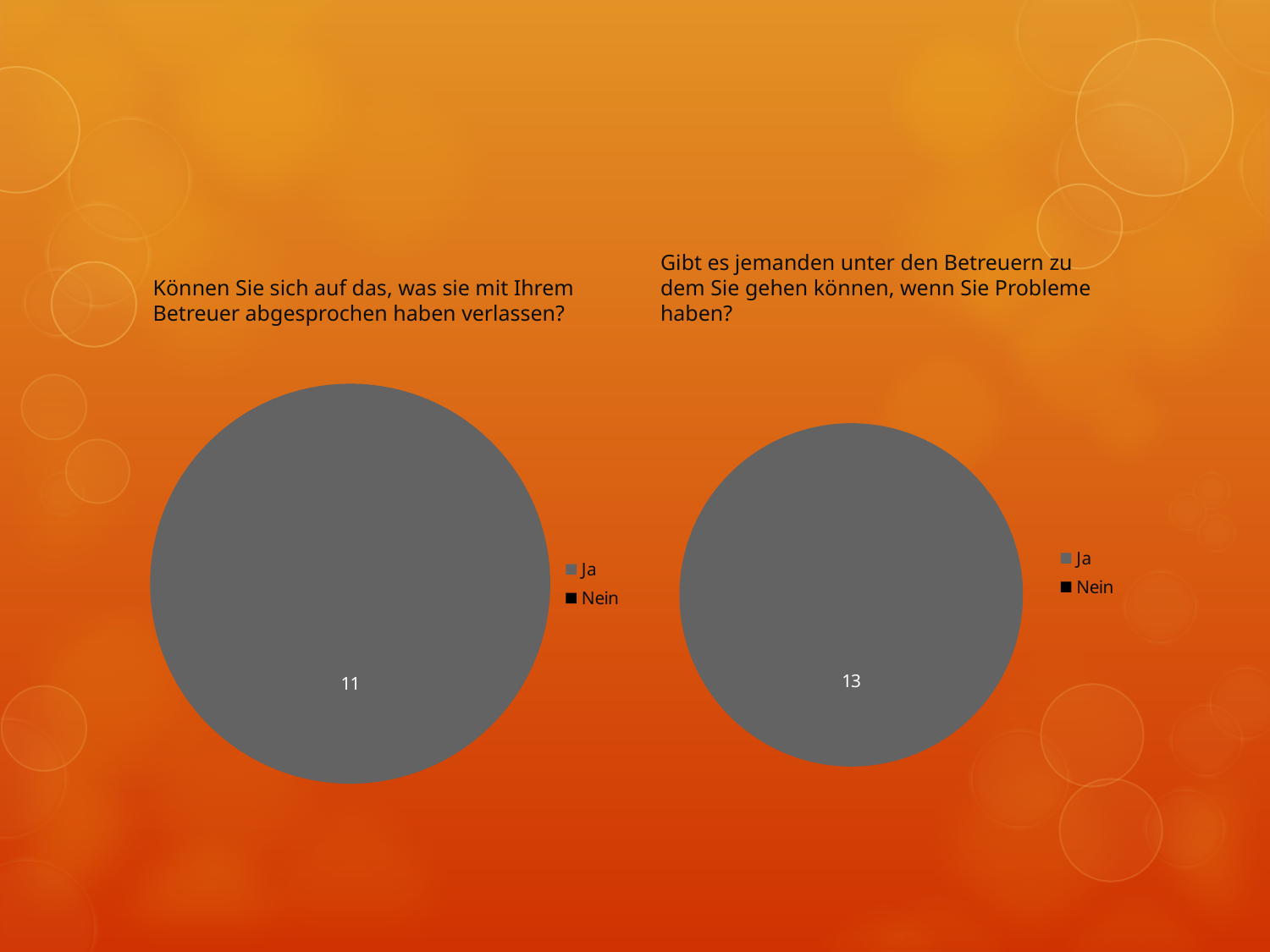
What is the difference between the value printed on the right chart (13) and the value printed on the left chart (11)? 2 Which chart shows the larger printed value, the left chart or the right chart? the right chart In the left chart ("Können Sie sich auf das, was sie mit Ihrem Betreuer abgesprochen haben verlassen?"), what value is printed on the pie? 11 What are the two legend entries shown for the right chart? Ja and Nein How many entries does the legend of the left chart list? 2 What type of chart is shown on the left of the slide? pie chart Is the value printed on the right chart greater or less than 10? greater In the right chart, what share of the pie does the "Ja" slice take up? 100% How many entries does the legend of the right chart list? 2 In the right chart ("Gibt es jemanden unter den Betreuern zu dem Sie gehen können, wenn Sie Probleme haben?"), what value is printed on the pie? 13 In the left chart, which legend category does the grey slice represent? Ja